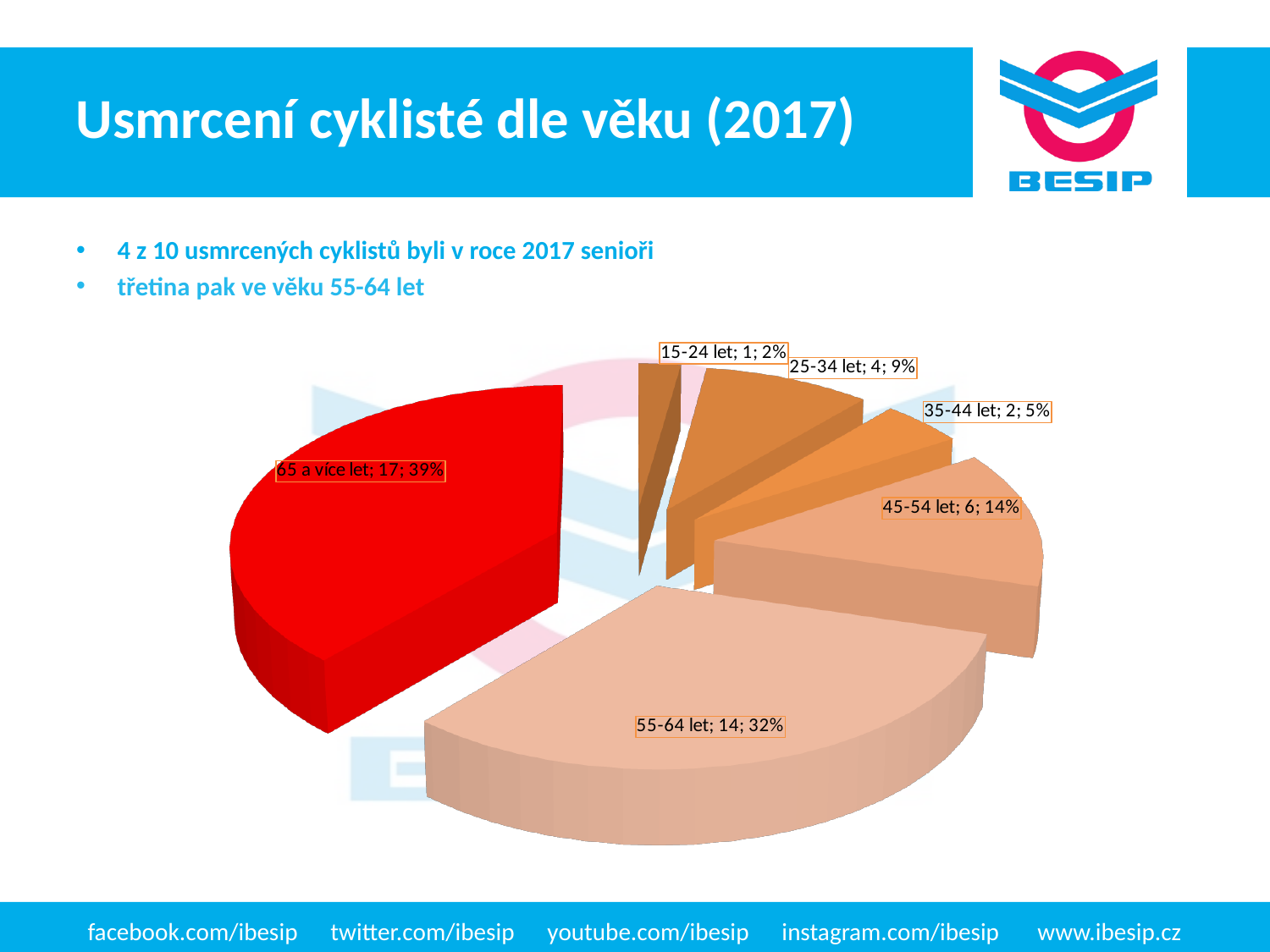
How many age categories does the pie chart show? 6 Which age category has the smallest slice of the pie? 15-24 let How many killed cyclists does the pie chart show for the 55-64 let category? 14 How many killed cyclists does the pie chart show for the 25-34 let category? 4 What share of the pie does the 65 a více let slice represent? 39% What share of the pie does the 45-54 let slice represent? 14% What is the total number of killed cyclists across all categories in the pie chart? 44 Which category has more killed cyclists, 35-44 let or 45-54 let? 45-54 let What is the title of the slide containing the pie chart? Usmrcení cyklisté dle věku (2017) What kind of chart is shown on the slide? pie chart Which age category has the largest slice of the pie? 65 a více let What is the difference in the number of killed cyclists between the 65 a více let and 55-64 let categories? 3